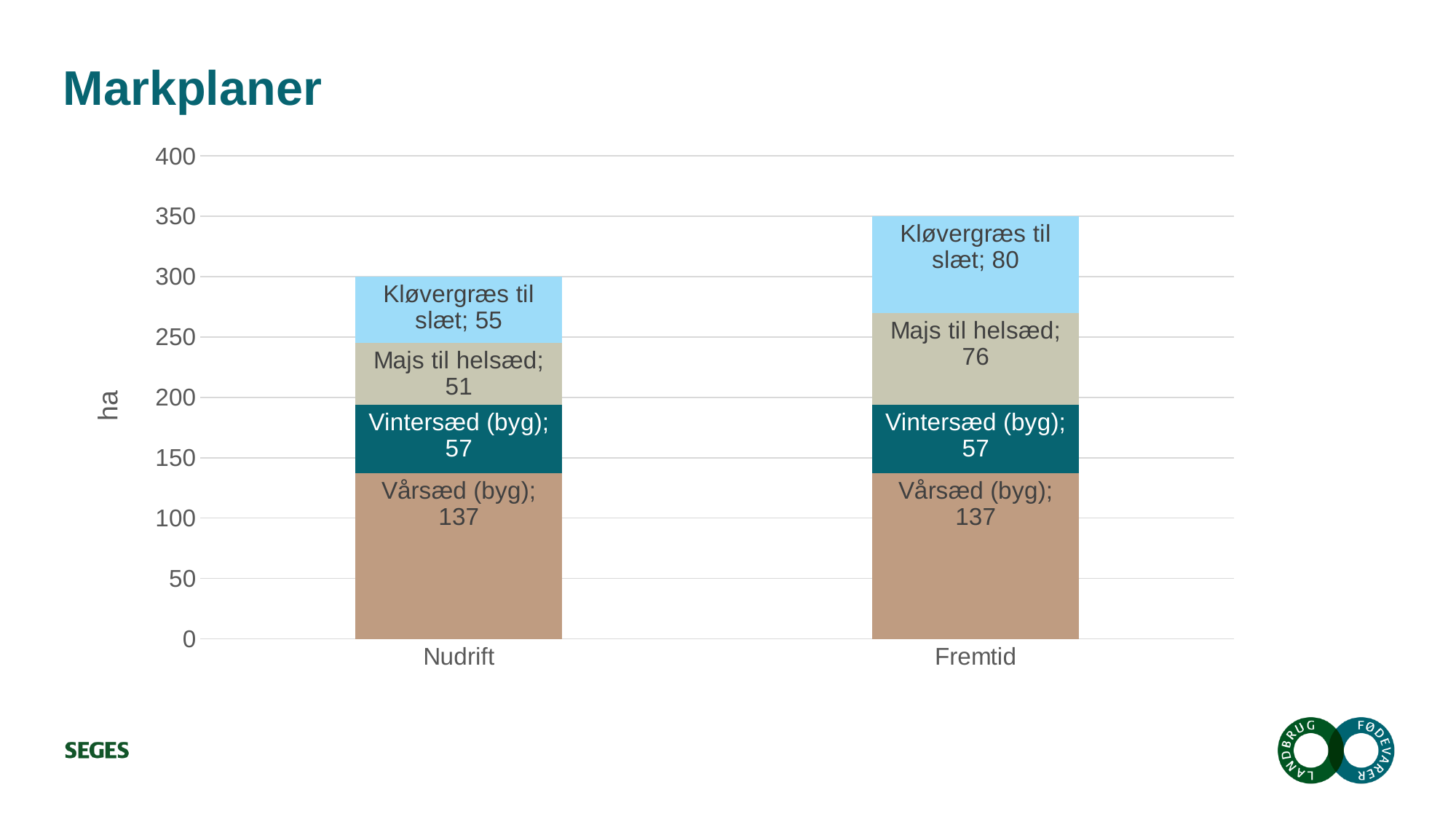
How many categories are shown on the x axis? 2 What is the value for Kløvergræs til slæt in the Fremtid bar? 80 What kind of chart is shown on the slide? stacked bar chart What is the total of the Nudrift stacked bar? 300 What is the label on the y axis? ha What is the value for Majs til helsæd in the Nudrift bar? 51 Which segment is the largest in the Nudrift bar? Vårsæd (byg) What is the value for Vårsæd (byg) in the Fremtid bar? 137 What is the total of the Fremtid stacked bar? 350 Which segment is the smallest in the Fremtid bar? Vintersæd (byg) Which is larger: Kløvergræs til slæt in Nudrift or in Fremtid? Fremtid What is the difference between Majs til helsæd in Fremtid and in Nudrift? 25